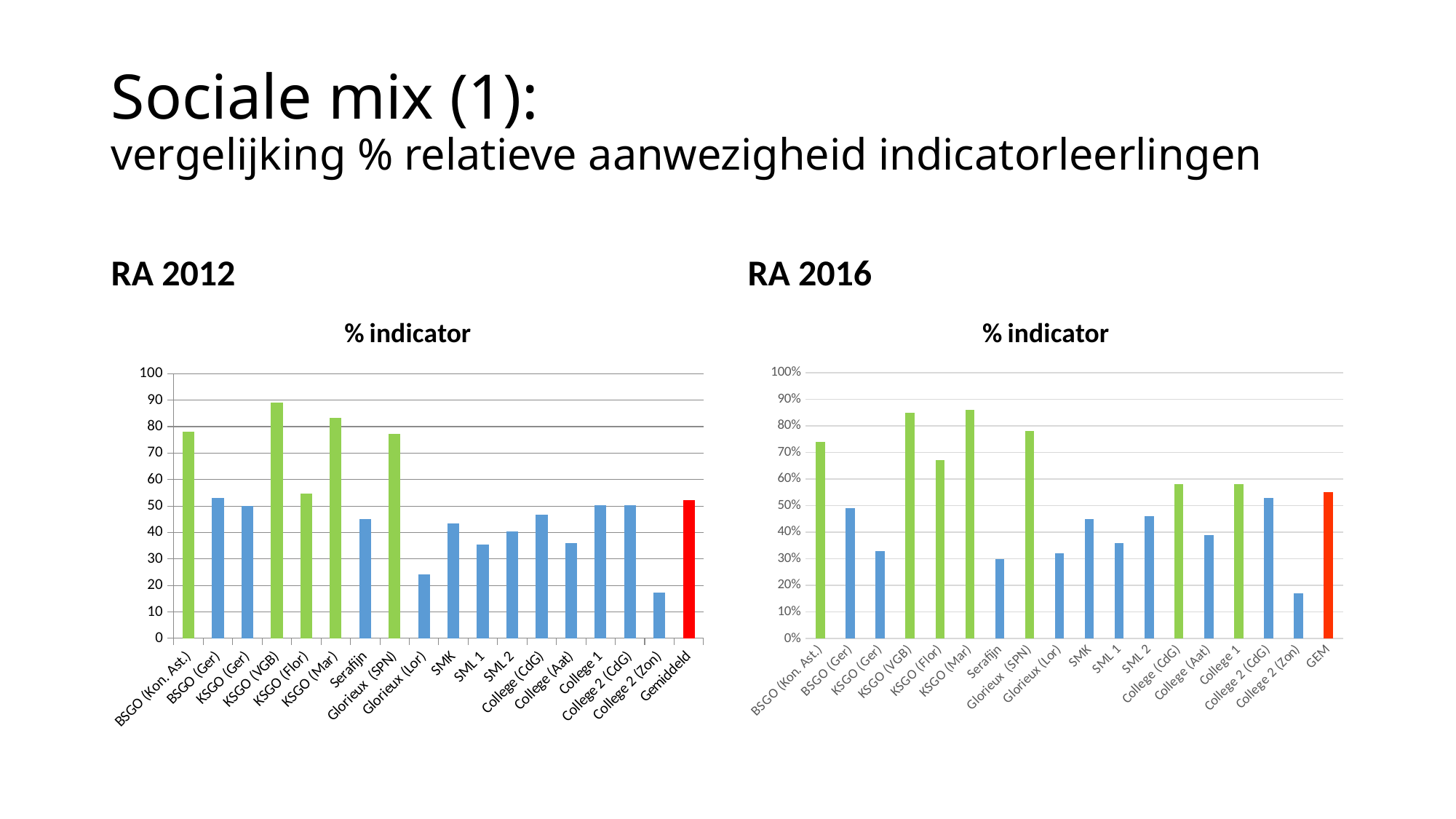
In the RA 2012 chart, is the value for KSGO (VGB) greater or less than 80? greater In the RA 2016 chart, is the value for KSGO (Flor) greater or less than 60%? greater In the RA 2016 chart, is the value for Serafijn greater or less than 40%? less In the RA 2012 chart, what colour is the Gemiddeld bar? red How many bars are shown in the RA 2016 chart? 18 What kind of chart is the RA 2012 chart? bar chart In the RA 2012 chart, which category has the lowest value? College 2 (Zon) In the RA 2012 chart, which category has the highest value? KSGO (VGB) In the RA 2012 chart, which is larger, the value for KSGO (Mar) or the value for Glorieux (SPN)? KSGO (Mar) In the RA 2016 chart, which is larger, the value for BSGO (Kon. Ast.) or the value for KSGO (Flor)? BSGO (Kon. Ast.) In the RA 2016 chart, which category has the lowest value? College 2 (Zon)